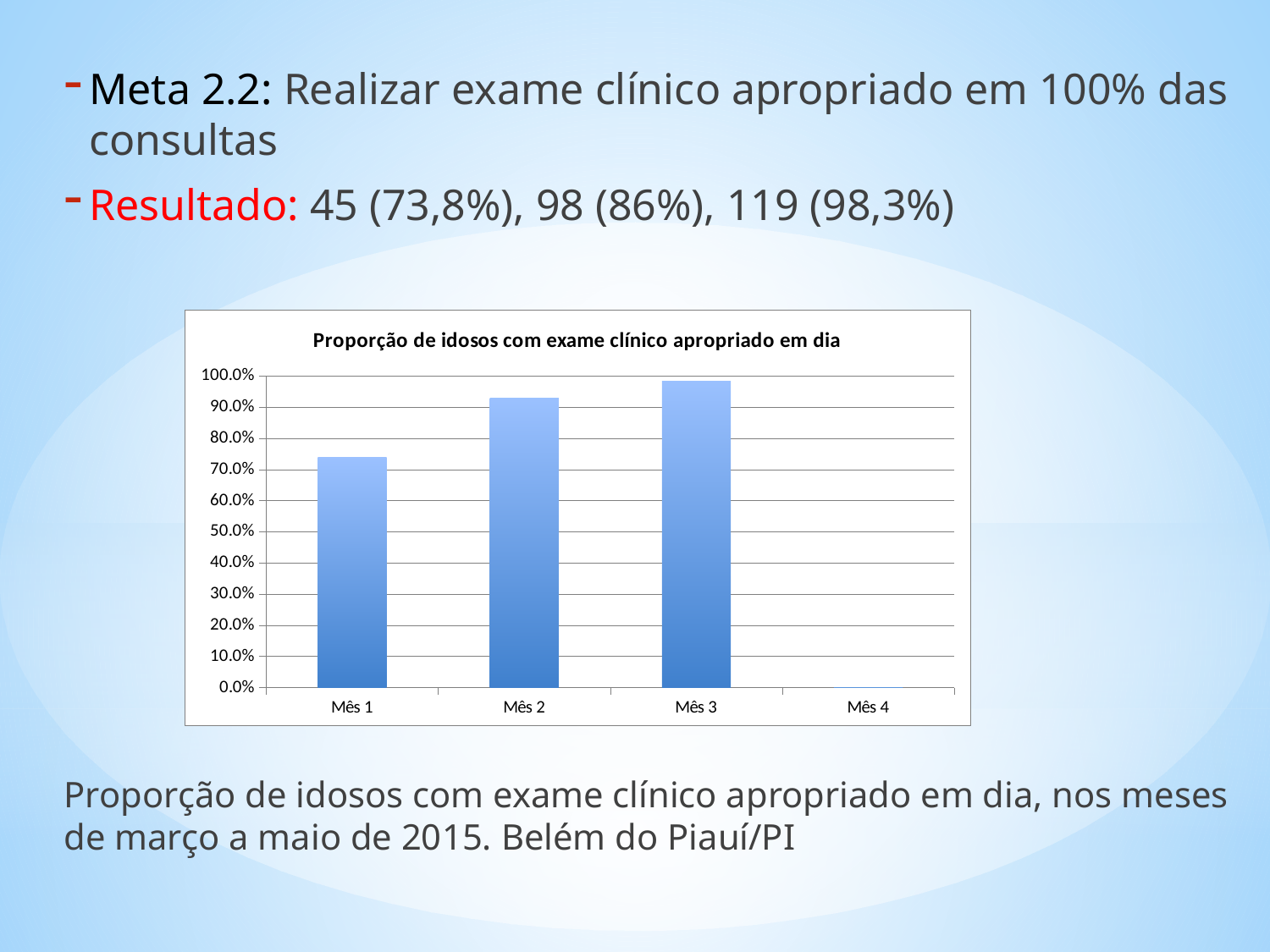
Which is larger, the value for Mês 1 or the value for Mês 2? Mês 2 What kind of chart is shown on the slide? bar chart Which month has the highest bar in the chart? Mês 3 Do the bar values rise or fall from Mês 1 to Mês 3? rise Is the value for Mês 2 greater or less than 90.0%? greater Is the value for Mês 1 greater or less than 80.0%? less Which is larger, the value for Mês 1 or the value for Mês 3? Mês 3 What is the title of the chart? Proporção de idosos com exame clínico apropriado em dia Is the value for Mês 1 greater or less than 70.0%? greater How many categories are shown on the x axis of the chart? 4 Which month on the x axis has no visible bar? Mês 4